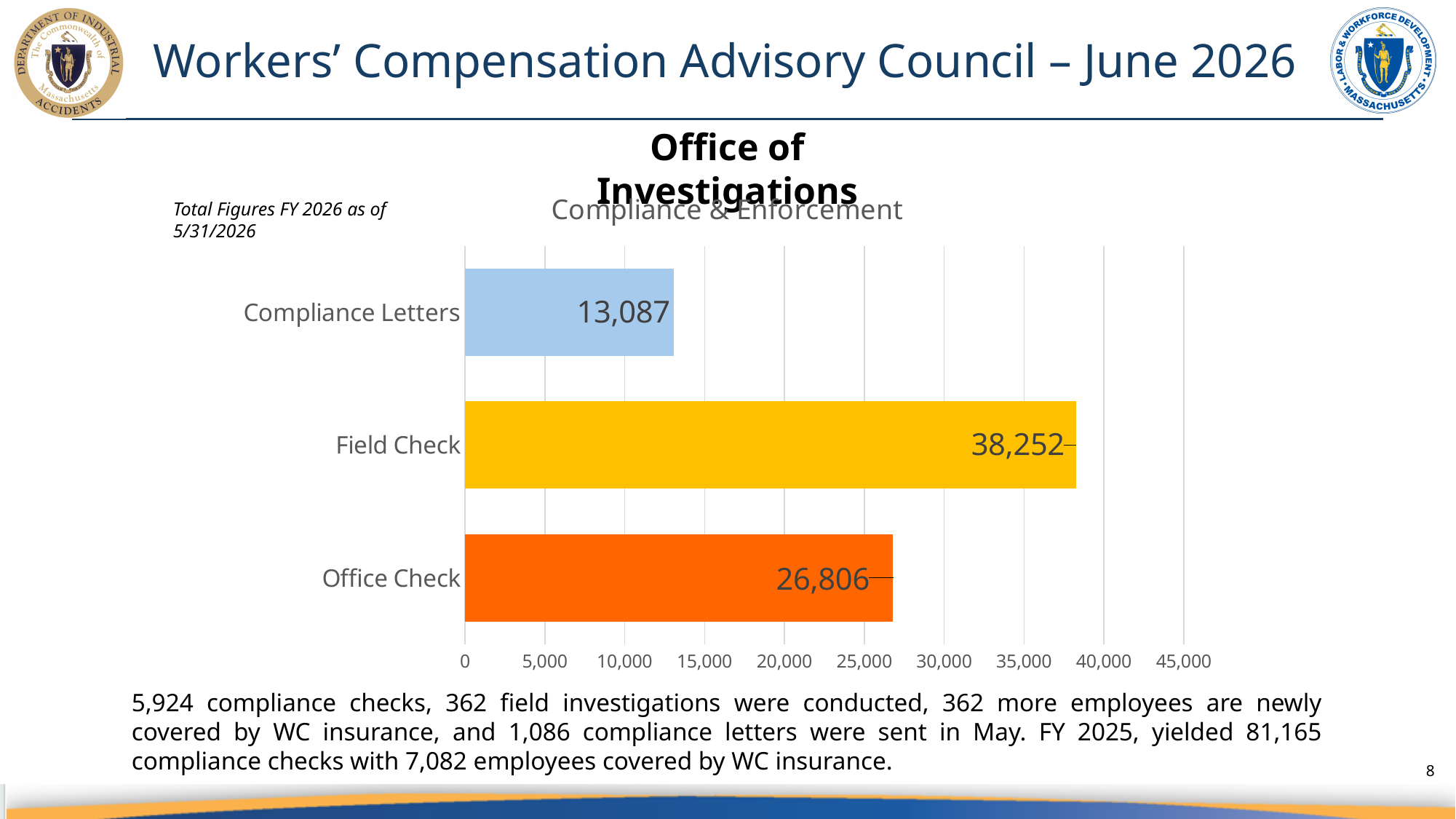
What is the subtitle shown below the chart title 'Office of Investigations'? Compliance & Enforcement What is the difference between the Field Check and Office Check values? 11,446 What is the difference between the Office Check and Compliance Letters values? 13,719 Is the value for Field Check greater or less than 35,000? greater What is the value for Compliance Letters? 13,087 What kind of chart is shown on the slide? bar chart Which category has the highest value? Field Check How many categories are shown in the chart? 3 What is the value for Office Check? 26,806 Which category has the lowest value? Compliance Letters Which is larger, the value for Office Check or the value for Compliance Letters? Office Check What is the value for Field Check? 38,252